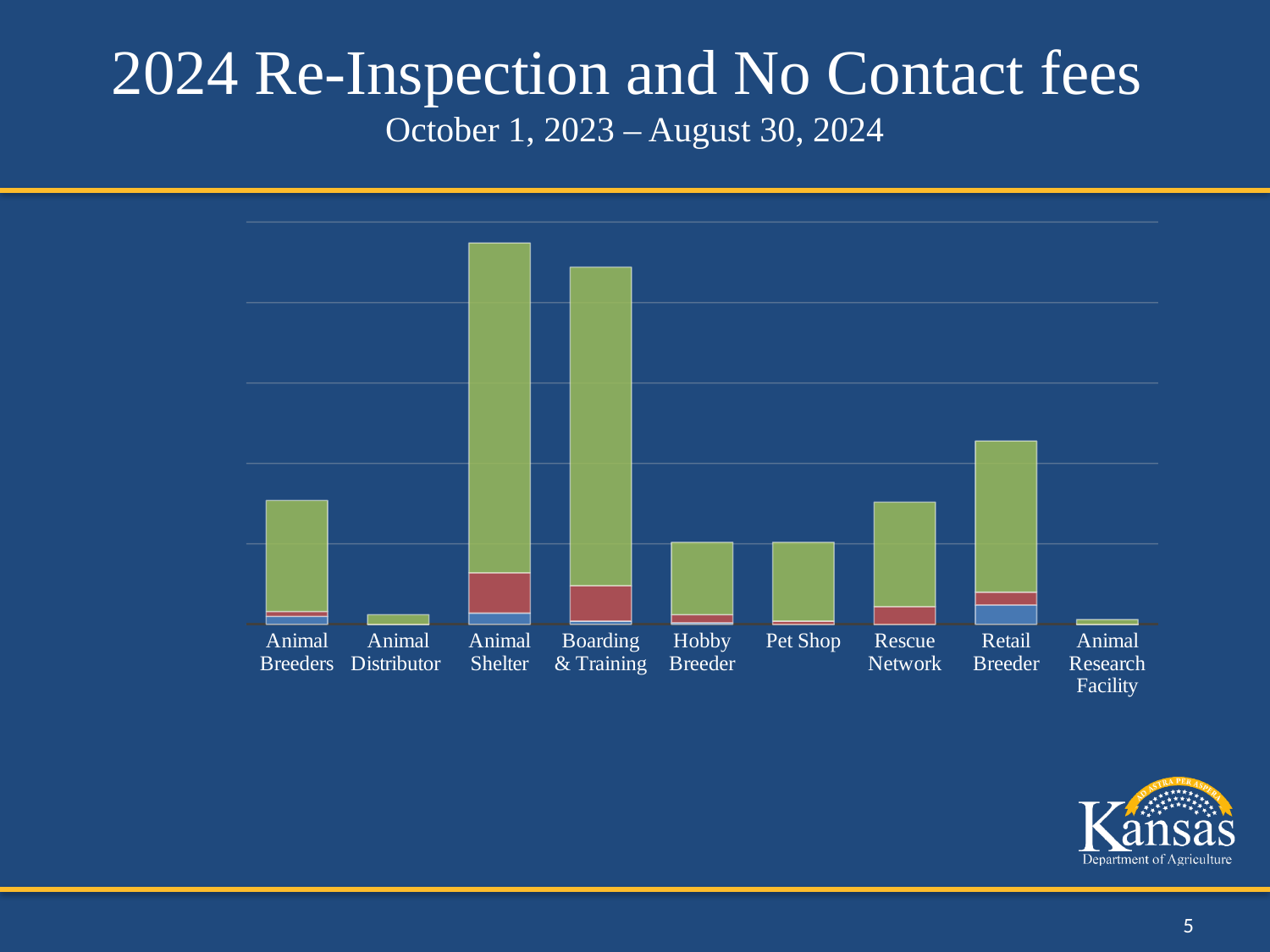
What kind of chart is shown on the slide? Stacked bar chart Which bar is taller, Animal Breeders or Hobby Breeder? Animal Breeders What is the title of the slide containing the chart? 2024 Re-Inspection and No Contact fees Which bar is taller, Pet Shop or Animal Distributor? Pet Shop Which category has the second tallest bar in the chart? Boarding & Training Which bar is taller, Animal Shelter or Boarding & Training? Animal Shelter What date range is given in the slide subtitle above the chart? October 1, 2023 – August 30, 2024 Which category has the tallest bar in the chart? Animal Shelter How many categories are shown along the x axis of the chart? 9